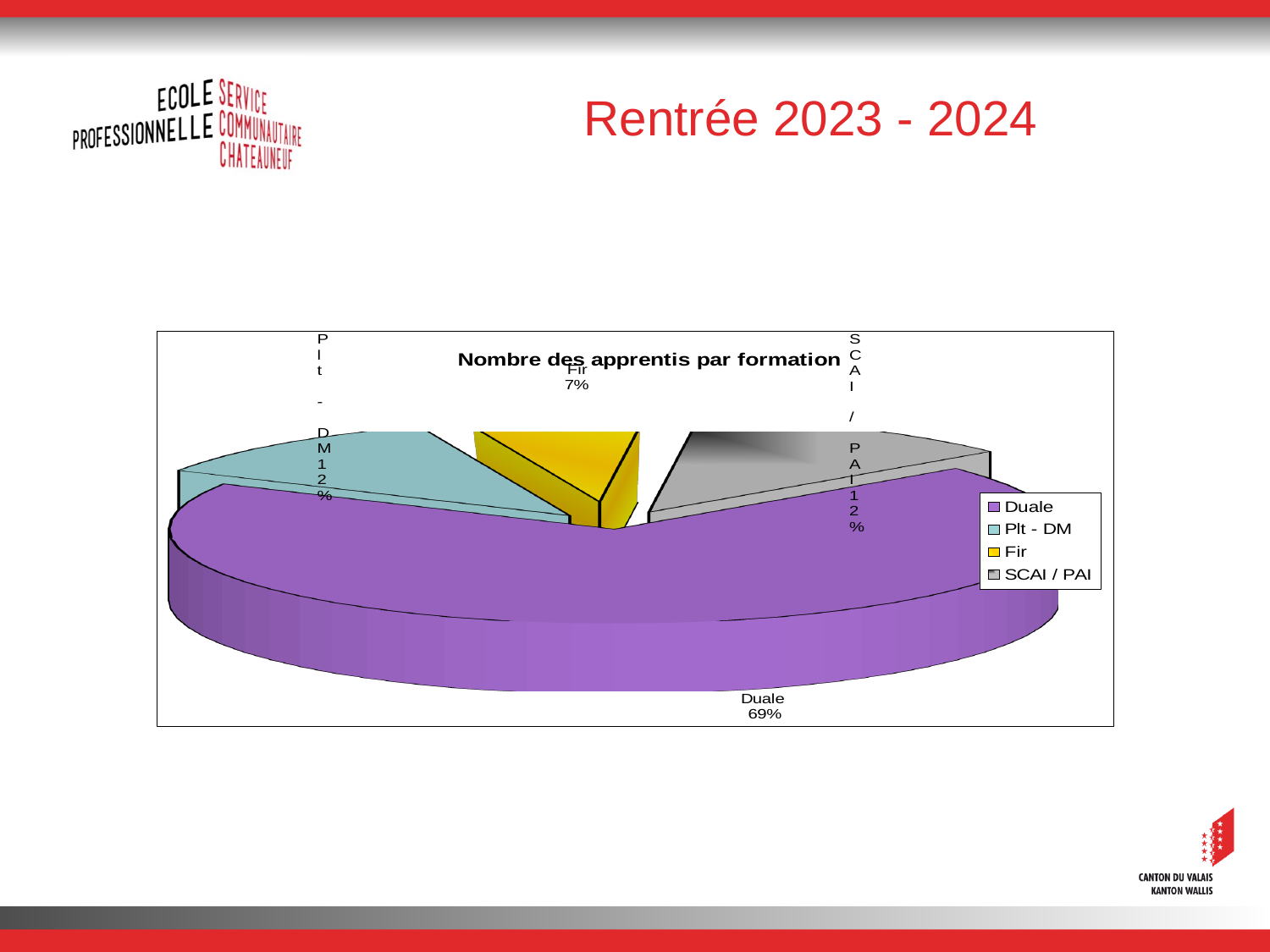
How many slices does the pie chart have? 4 What is the title of the chart? Nombre des apprentis par formation What share of the pie does the Plt - DM slice represent? 12% What type of chart is shown on the slide? pie chart Which category has the largest slice of the pie? Duale What colour is the Duale slice in the pie chart? purple What share of the pie does the SCAI / PAI slice represent? 12% Which category has the smallest slice of the pie? Fir How many percentage points larger is the Duale share than the Fir share? 62 Which is larger, the share for Plt - DM or the share for Fir? Plt - DM What share of the pie does the Fir slice represent? 7%